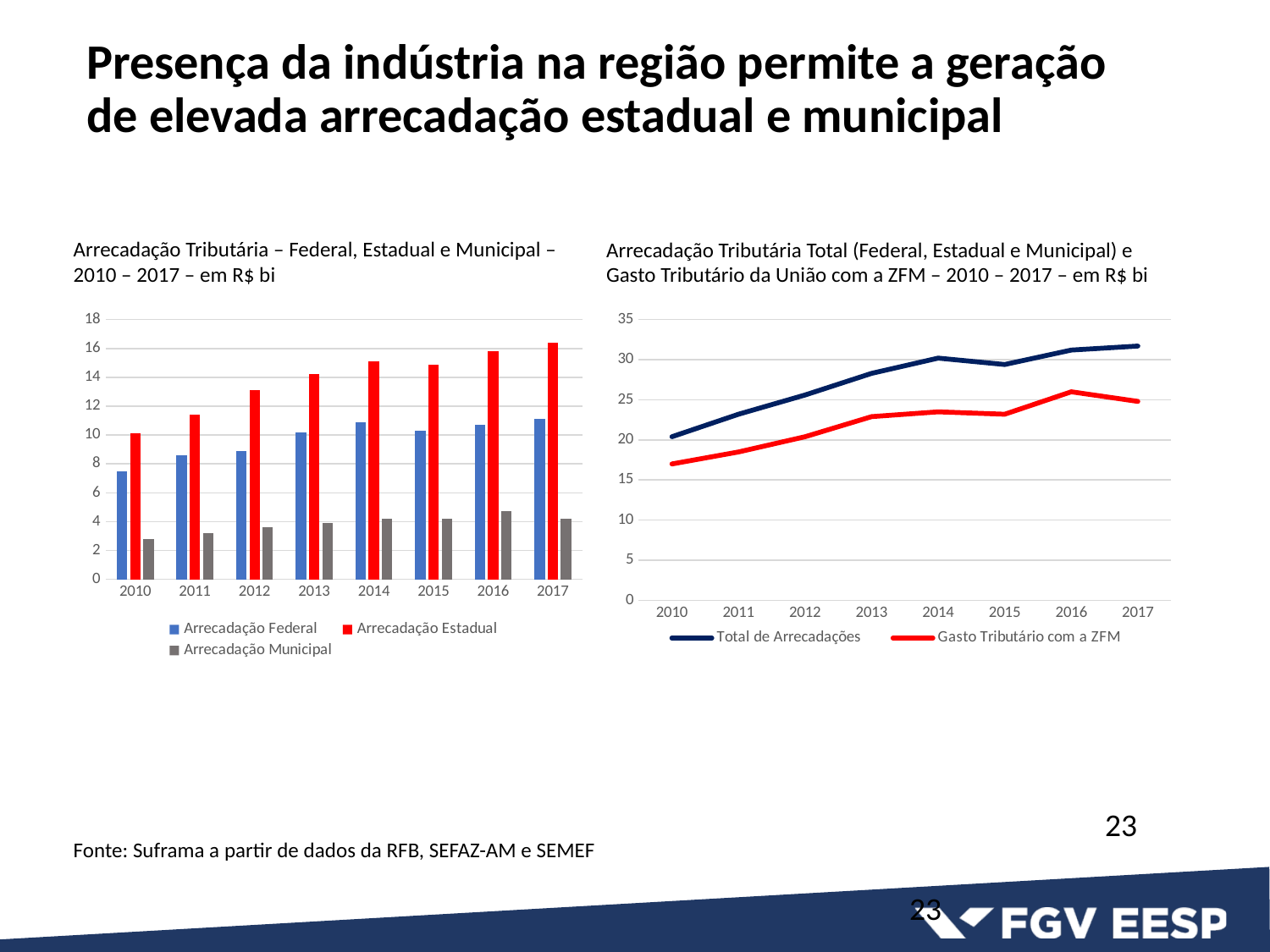
In the left chart, how many series does the legend list? 3 In the left chart, how many years are shown on the x axis? 8 In the left chart, which is larger in 2015: Arrecadação Estadual or Arrecadação Federal? Arrecadação Estadual In the left chart, in which year is Arrecadação Municipal lowest? 2010 In the right chart, how many series does the legend list? 2 In the left chart, is the value for Arrecadação Federal in 2010 greater or less than 8? less In the left chart, is the value for Arrecadação Federal in 2014 greater or less than 10? greater In the left chart, in which year is Arrecadação Estadual highest? 2017 In the right chart, does Total de Arrecadações generally rise or fall from 2010 to 2017? Rise What kind of chart is the left chart, 'Arrecadação Tributária – Federal, Estadual e Municipal – 2010 – 2017 – em R$ bi'? Bar chart What kind of chart is the right chart, 'Arrecadação Tributária Total (Federal, Estadual e Municipal) e Gasto Tributário da União com a ZFM – 2010 – 2017 – em R$ bi'? Line chart In the right chart, is the value for Total de Arrecadações in 2017 greater or less than 30? greater